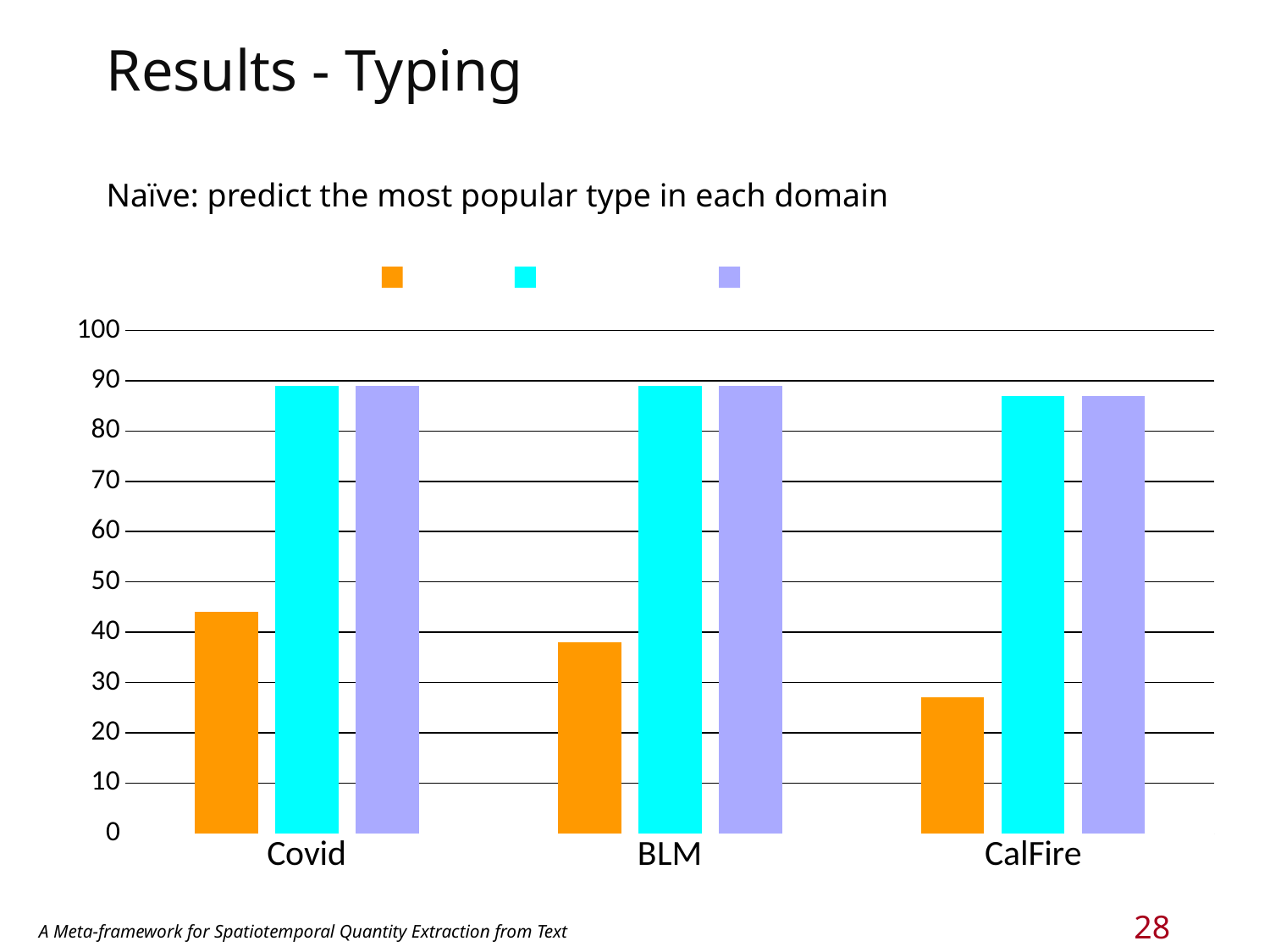
Do the orange bars rise or fall from Covid to CalFire along the x axis? fall Is the cyan bar for Covid greater or less than 80? greater How many series does the chart's legend list? 3 Is the orange bar for BLM greater or less than 40? less Is the purple bar for CalFire greater or less than 90? less How many categories are shown on the x axis of the chart? 3 Which category has the highest orange bar? Covid For BLM, which is larger: the orange bar or the cyan bar? the cyan bar What kind of chart is shown on the slide? bar chart Which category has the lowest orange bar? CalFire